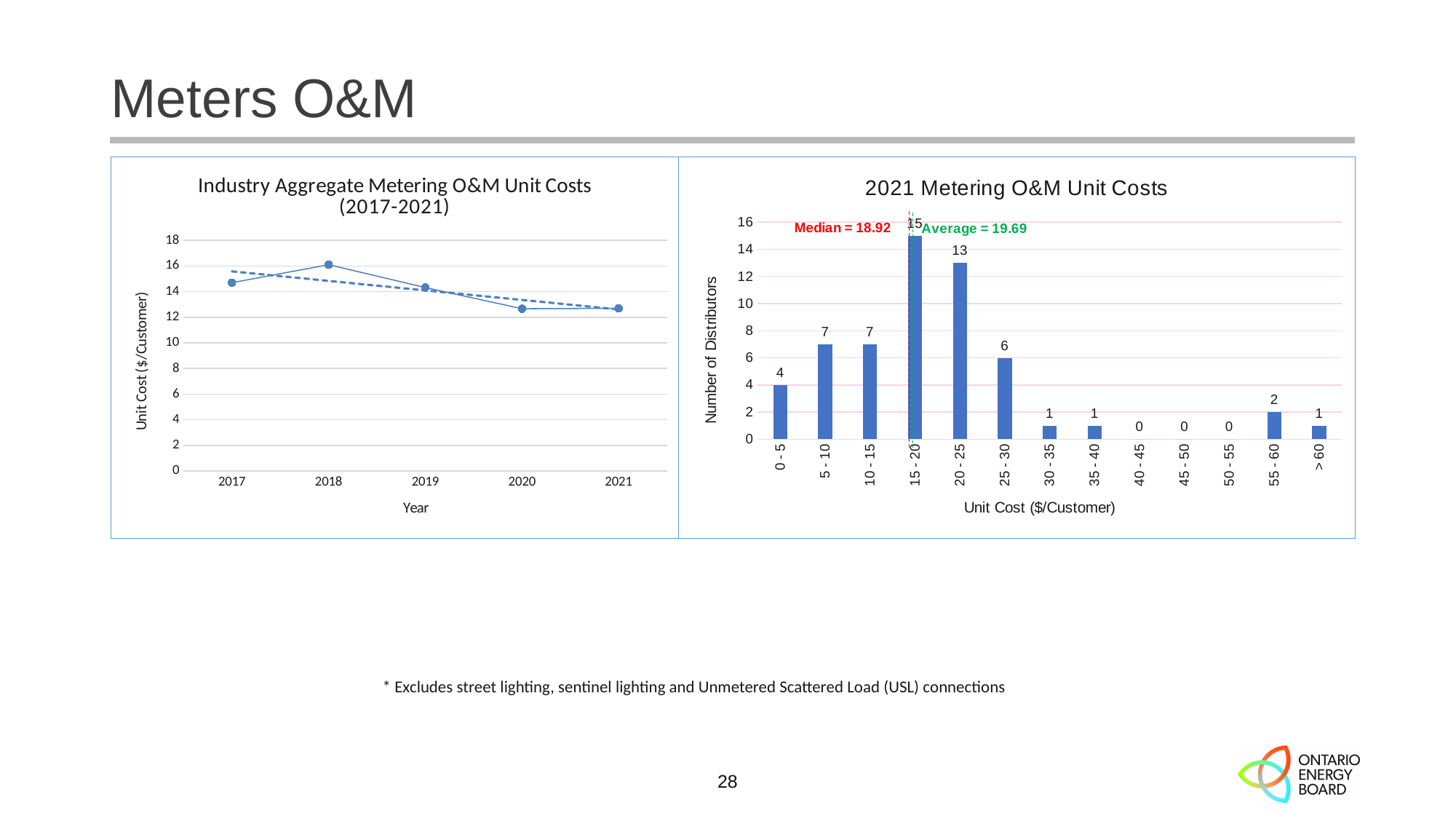
In the 'Industry Aggregate Metering O&M Unit Costs (2017-2021)' chart, how many years are plotted? 5 What kind of chart is the '2021 Metering O&M Unit Costs' chart on the right? bar chart In the '2021 Metering O&M Unit Costs' chart, how many distributors are in the 15 - 20 unit cost range? 15 In the '2021 Metering O&M Unit Costs' chart, what median value is shown? 18.92 In the '2021 Metering O&M Unit Costs' chart, how many distributors are in the 20 - 25 unit cost range? 13 In the 'Industry Aggregate Metering O&M Unit Costs (2017-2021)' chart, is the unit cost for 2017 greater or less than 14? greater In the 'Industry Aggregate Metering O&M Unit Costs (2017-2021)' chart, which year has the highest unit cost? 2018 What kind of chart is the 'Industry Aggregate Metering O&M Unit Costs (2017-2021)' chart on the left? line chart In the 'Industry Aggregate Metering O&M Unit Costs (2017-2021)' chart, is the unit cost for 2020 greater or less than 14? less In the '2021 Metering O&M Unit Costs' chart, which unit cost range has the most distributors? 15 - 20 In the '2021 Metering O&M Unit Costs' chart, what is the difference in number of distributors between the 15 - 20 and 20 - 25 ranges? 2 In the 'Industry Aggregate Metering O&M Unit Costs (2017-2021)' chart, do unit costs generally rise or fall from 2018 to 2021? fall